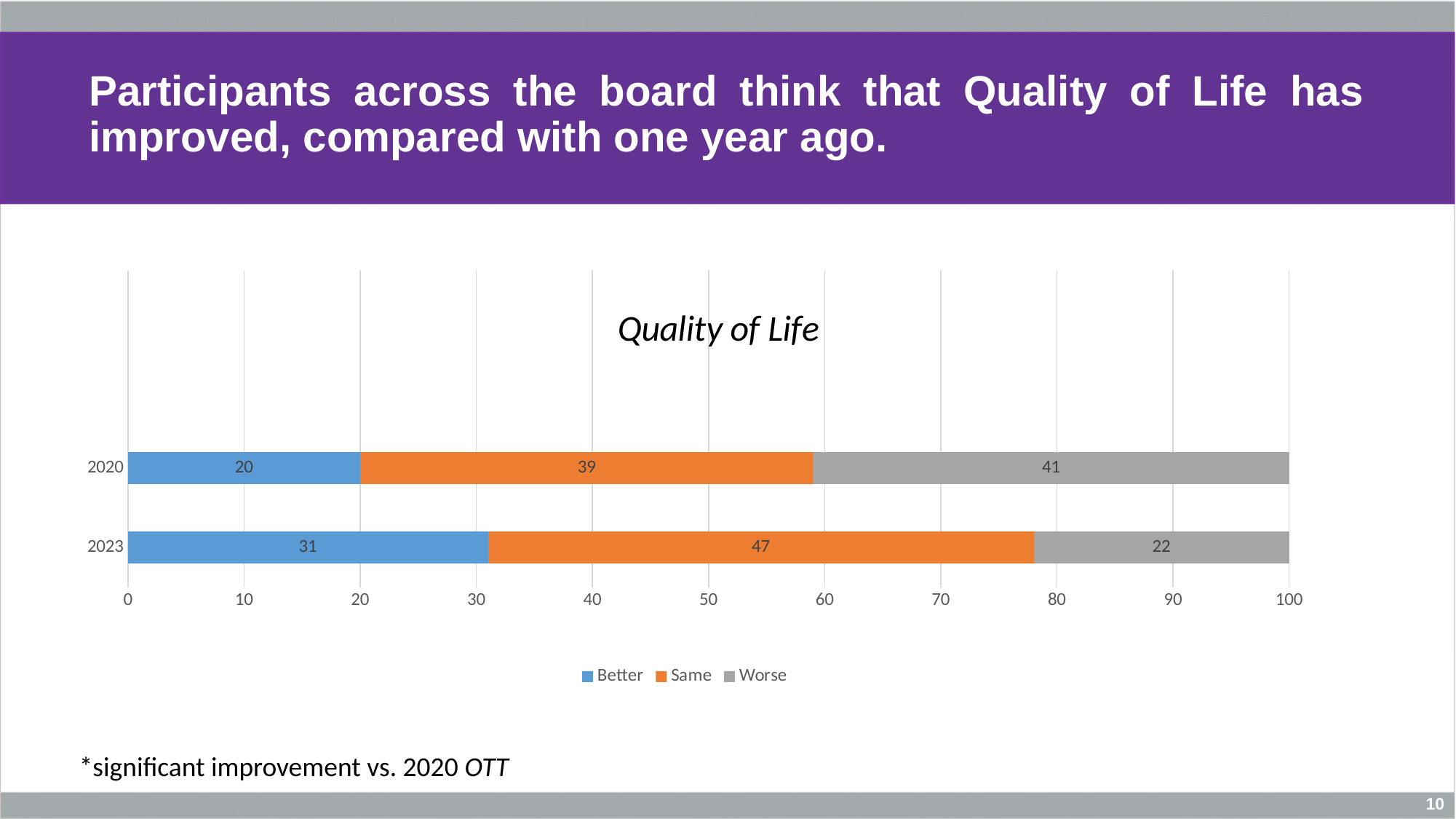
What is the total of the stacked bar for 2020? 100 Which year has the higher value for Worse? 2020 How many categories (years) are shown on the chart? 2 What is the difference between the Worse values for 2020 and 2023? 19 How many series does the legend list? 3 What is the value for Better in 2020? 20 What is the title of the chart? Quality of Life What is the value for Same in 2023? 47 What is the difference between the Better values for 2023 and 2020? 11 What is the value for Worse in 2020? 41 What is the value for Better in 2023? 31 What kind of chart is shown on the slide? Stacked bar chart